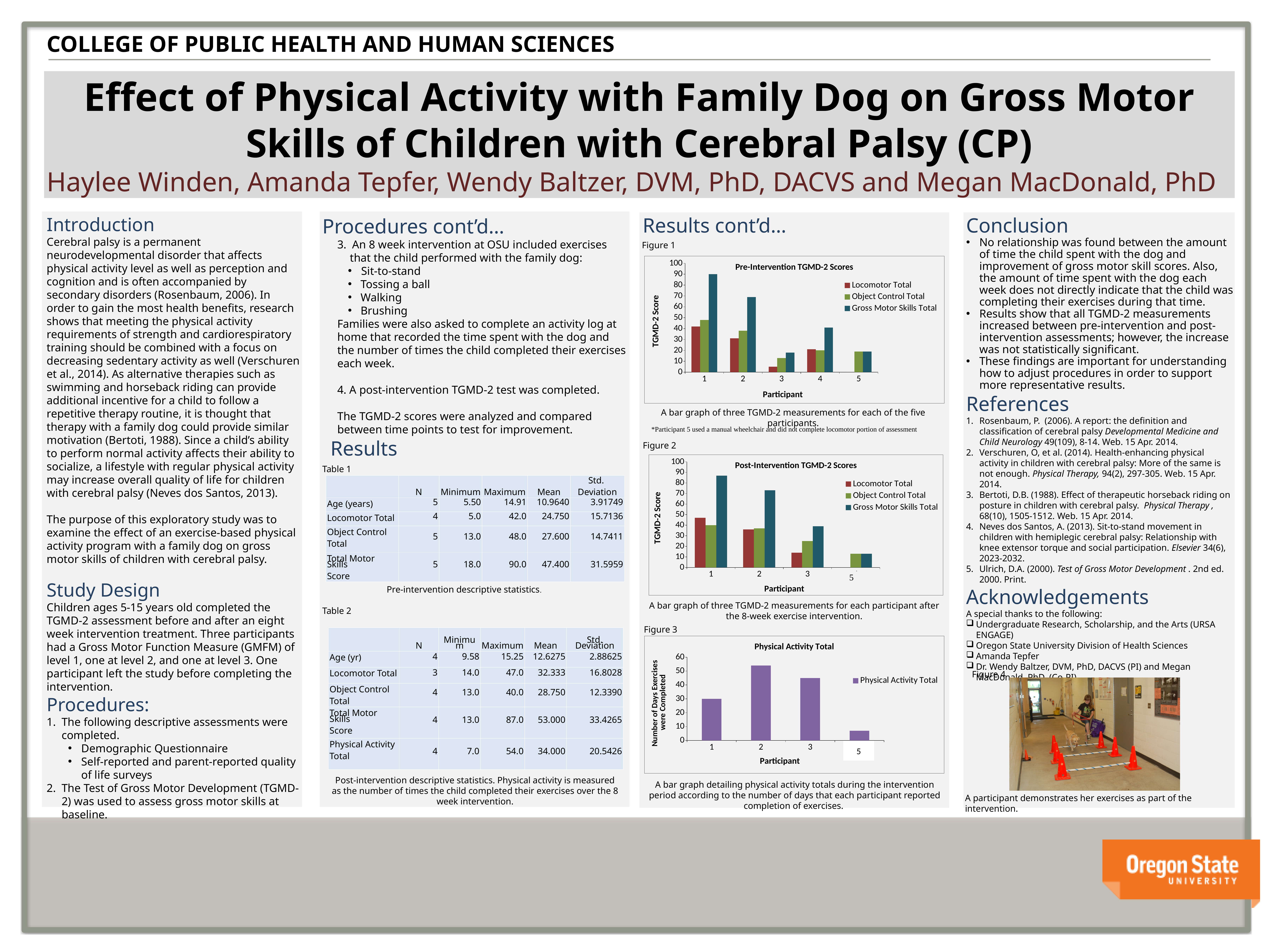
How many series does the legend of the Pre-Intervention TGMD-2 Scores chart list? 3 In the Pre-Intervention TGMD-2 Scores chart, which participant has the higher Locomotor Total, participant 1 or participant 2? Participant 1 In the Post-Intervention TGMD-2 Scores chart, is the Gross Motor Skills Total for participant 2 greater or less than 60? greater In the Physical Activity Total chart, is the value for participant 5 greater or less than 10? less What kind of chart is the Physical Activity Total chart? Bar chart In the Pre-Intervention TGMD-2 Scores chart, is the Locomotor Total for participant 3 greater or less than 10? less In the Post-Intervention TGMD-2 Scores chart, which participant has the lowest Gross Motor Skills Total? Participant 5 How many participants are shown on the x axis of the Physical Activity Total chart? 4 In the Physical Activity Total chart, which participant has the highest value? Participant 2 In the Post-Intervention TGMD-2 Scores chart, which participant has the higher Object Control Total, participant 2 or participant 3? Participant 2 In the Pre-Intervention TGMD-2 Scores chart, which participant has the highest Gross Motor Skills Total? Participant 1